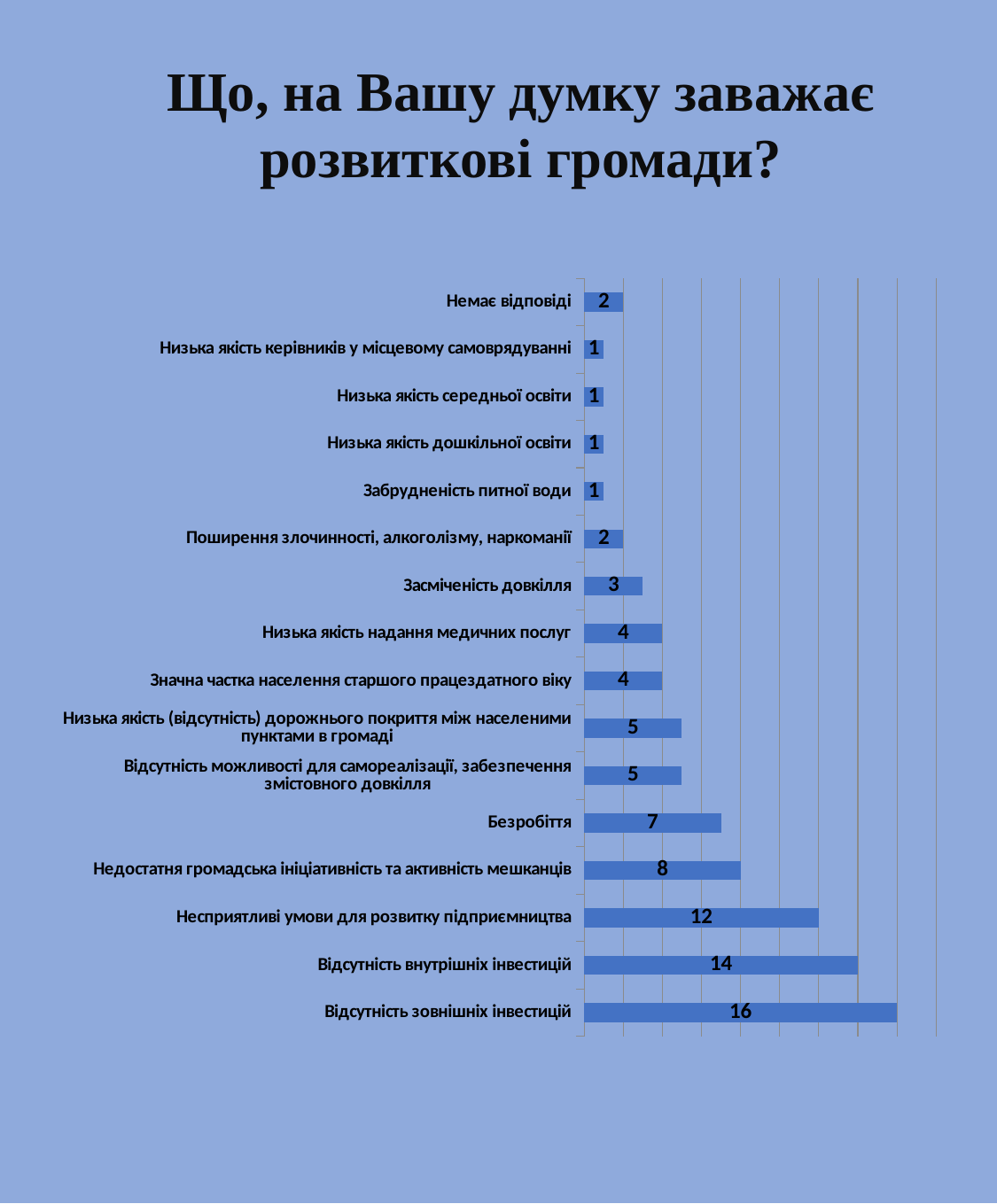
What is the value for "Засміченість довкілля"? 3 What is the value for "Немає відповіді"? 2 Which is larger: the value for "Недостатня громадська ініціативність та активність мешканців" or the value for "Безробіття"? Недостатня громадська ініціативність та активність мешканців What is the difference between the values for "Відсутність зовнішніх інвестицій" and "Відсутність внутрішніх інвестицій"? 2 What is the difference between the values for "Несприятливі умови для розвитку підприємництва" and "Безробіття"? 5 How many categories are shown in the chart? 16 What is the value for "Несприятливі умови для розвитку підприємництва"? 12 What is the value for "Безробіття"? 7 What type of chart is shown on the slide? bar chart What is the value for "Відсутність зовнішніх інвестицій"? 16 Which category has the highest value? Відсутність зовнішніх інвестицій What is the title of the slide? Що, на Вашу думку заважає розвиткові громади?